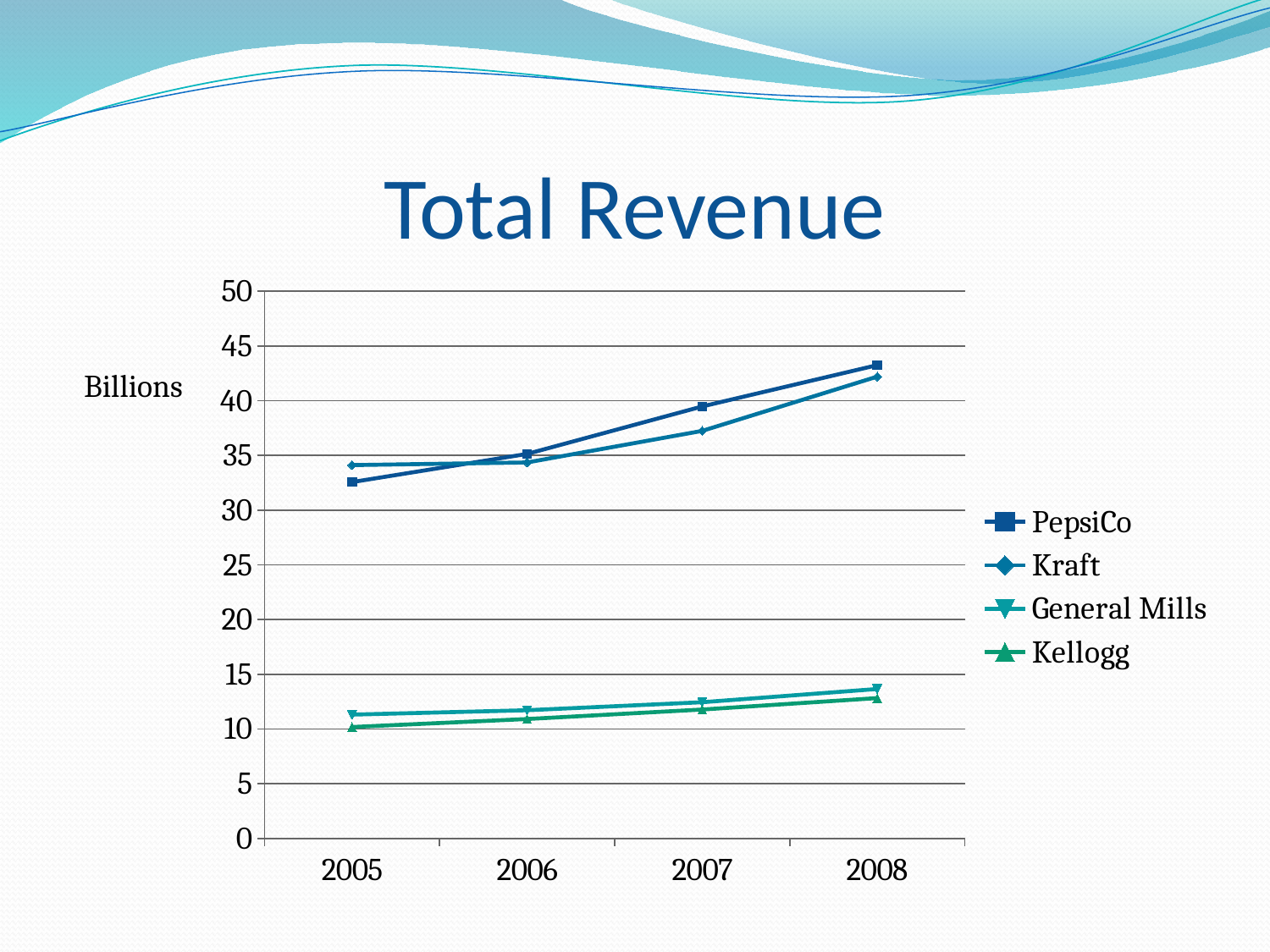
How many series does the legend list? 4 In 2005, which is larger: the value for Kraft or the value for PepsiCo? Kraft What is the title of the chart? Total Revenue Is the value for Kellogg in 2005 greater or less than 15? less Which company has the highest total revenue in 2008? PepsiCo How many years are plotted along the x axis? 4 Which company has the lowest total revenue in 2005? Kellogg Is the value for Kraft in 2005 greater or less than 30? greater Is the value for PepsiCo in 2008 greater or less than 40? greater What unit label is shown next to the vertical axis? Billions Does PepsiCo's total revenue rise or fall from 2005 to 2008? rise What kind of chart is shown on the slide? line chart